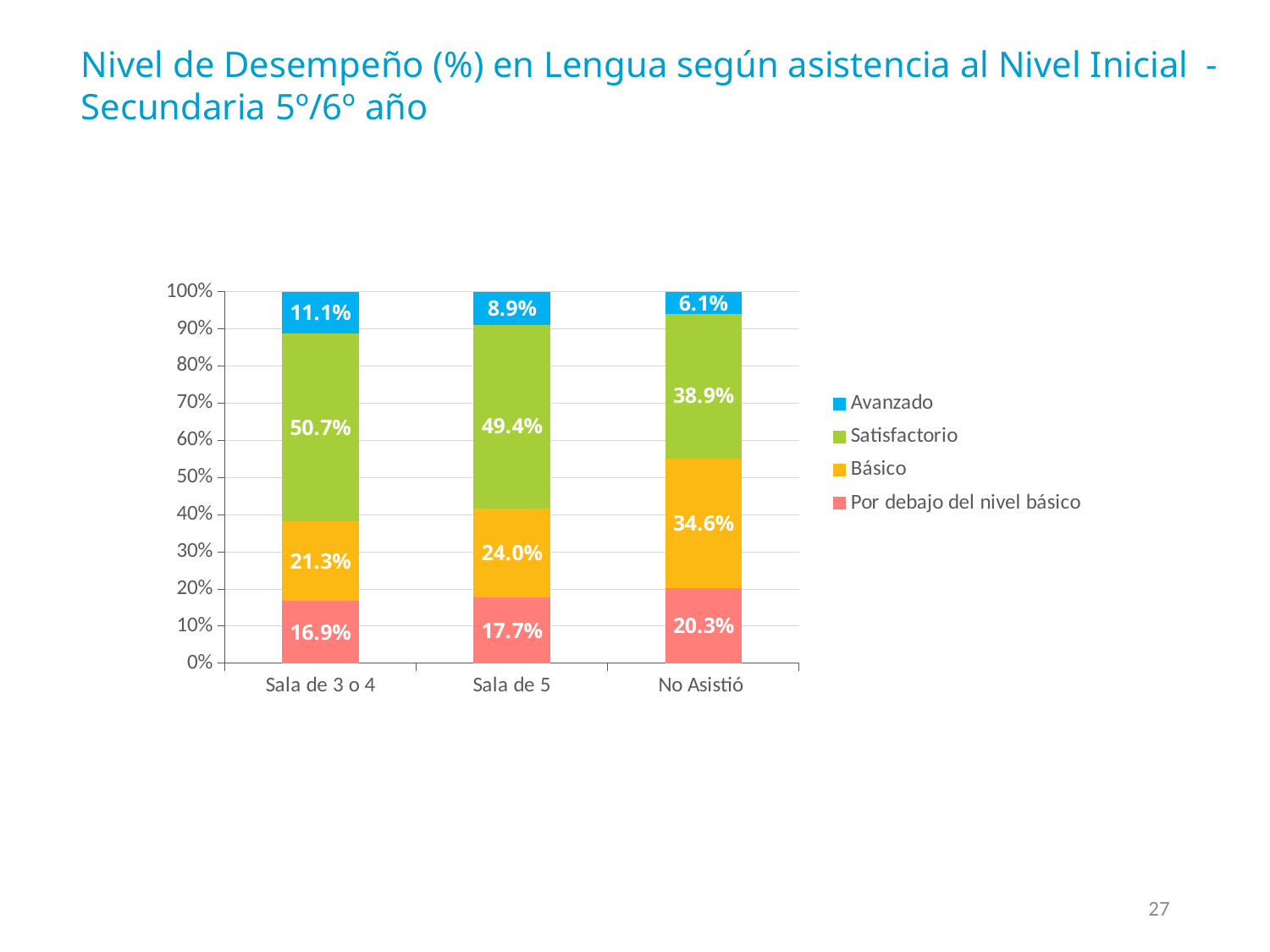
How many categories are shown on the x axis? 3 Do the Avanzado values rise or fall from Sala de 3 o 4 to No Asistió? Fall What kind of chart is shown on the slide? Stacked bar chart What is the difference between the Básico values for No Asistió and Sala de 3 o 4? 13.3% Which is larger, the Por debajo del nivel básico value for No Asistió or for Sala de 3 o 4? No Asistió What is the Básico value for No Asistió? 34.6% What is the Satisfactorio value for Sala de 5? 49.4% How many series does the legend list? 4 What is the Avanzado value for Sala de 3 o 4? 11.1% What is the Por debajo del nivel básico value for Sala de 5? 17.7% Which category has the highest Avanzado value? Sala de 3 o 4 Which category has the lowest Satisfactorio value? No Asistió